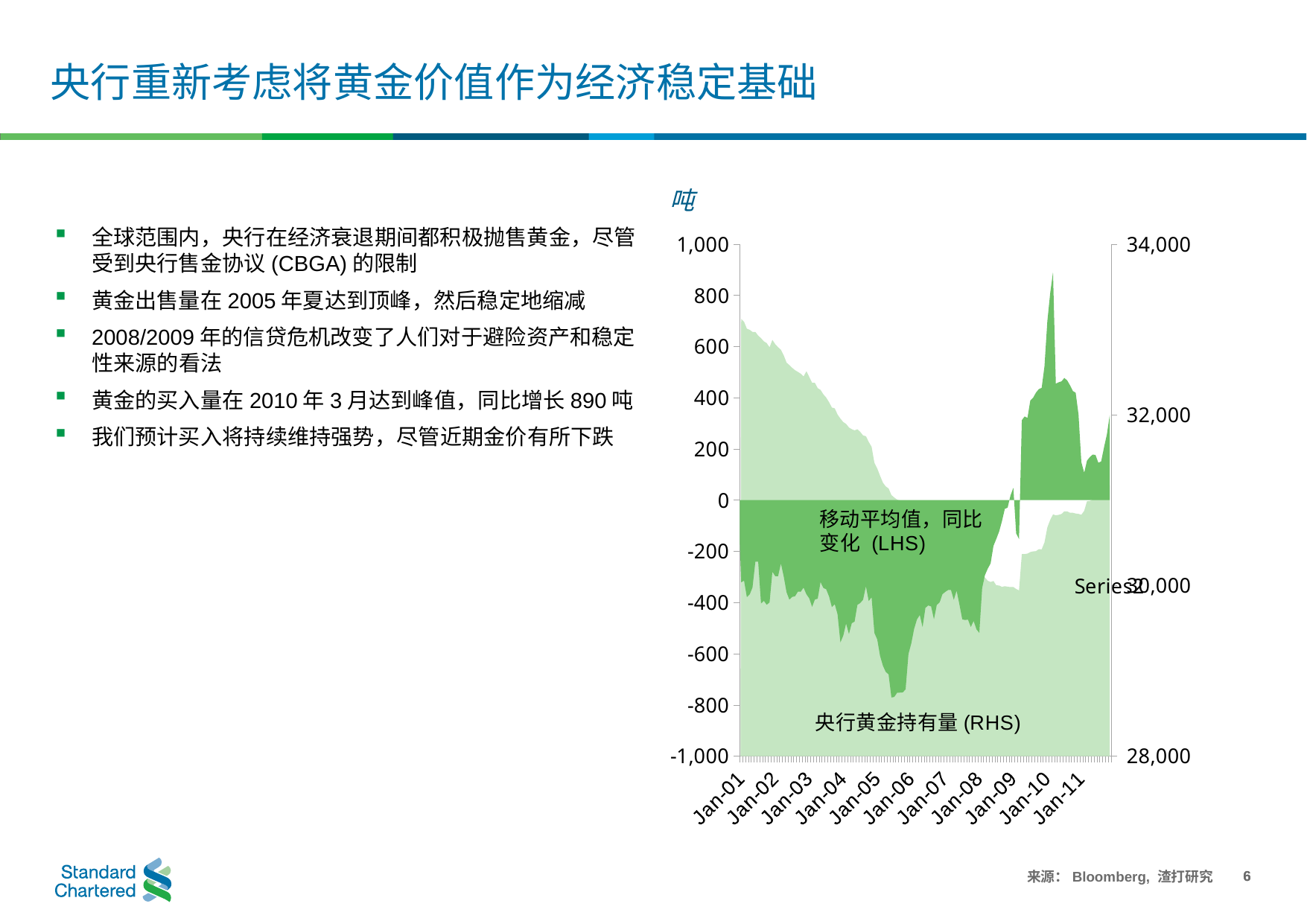
How many date labels are shown on the x axis of the chart? 11 Is the 移动平均值，同比变化 (LHS) series mostly positive or negative between Jan-01 and Jan-08? negative What is the first date label on the x axis of the chart? Jan-01 Around which x-axis label does the 移动平均值，同比变化 (LHS) series reach its highest point? Jan-10 Is the value of the 央行黄金持有量 (RHS) series at Jan-01 greater or less than 32,000? greater Does the 央行黄金持有量 (RHS) series rise or fall from Jan-01 to Jan-08? fall How many series are plotted in the chart? 2 Around which x-axis label does the 移动平均值，同比变化 (LHS) series reach its lowest point? Jan-06 Is the peak value of the 移动平均值，同比变化 (LHS) series around Jan-10 greater or less than 800? greater What is the highest value shown on the right-hand axis of the chart? 34,000 What kind of chart is shown on the slide? area chart